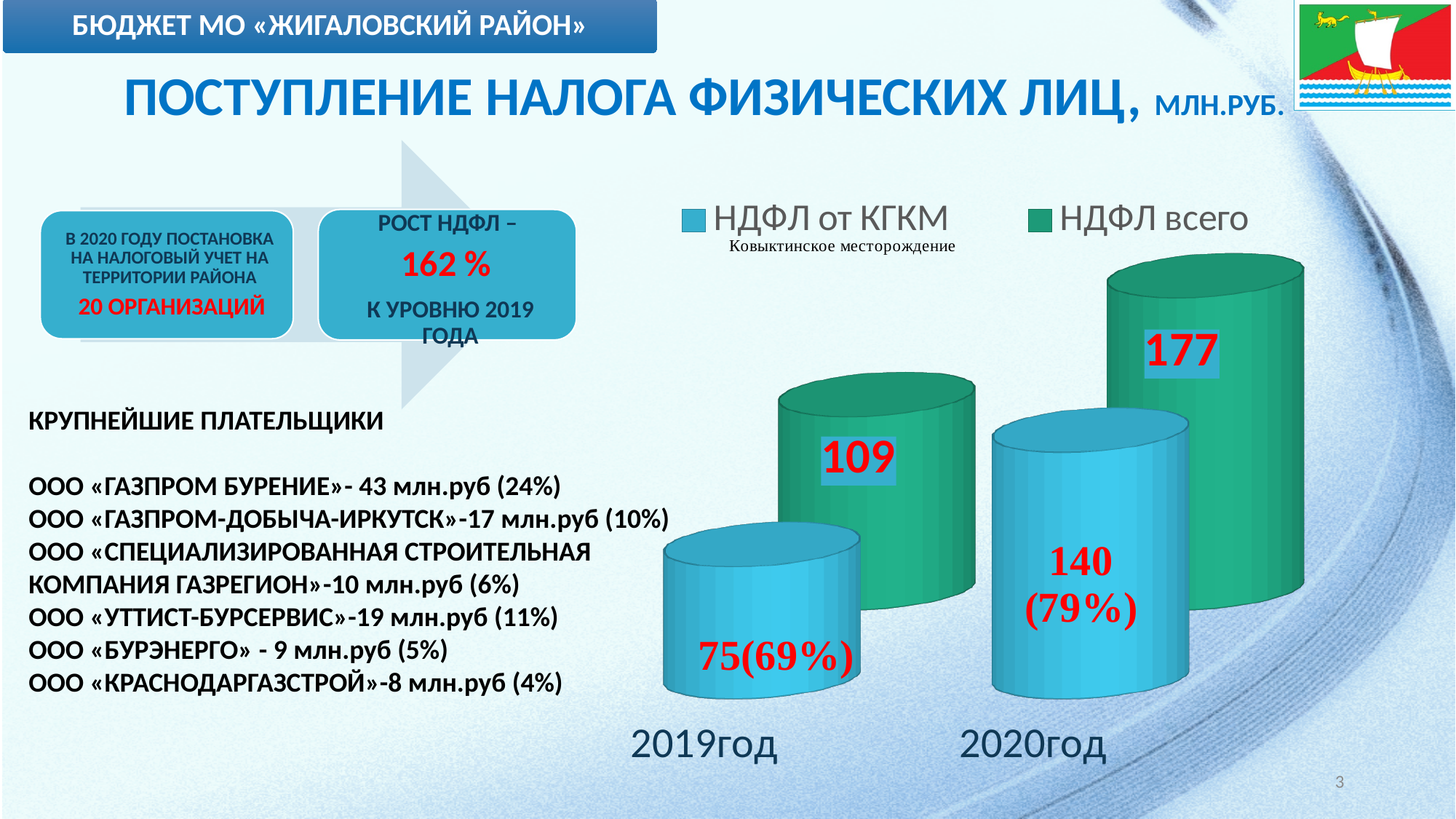
Does НДФЛ всего rise or fall from 2019год to 2020год? rise What is the value of НДФЛ всего for 2019год? 109 What value is labelled on the НДФЛ от КГКМ bar for 2019год? 75(69%) What value is labelled on the НДФЛ от КГКМ bar for 2020год? 140 (79%) How many series does the chart legend list? 2 Which is larger: НДФЛ от КГКМ in 2020год or НДФЛ всего in 2019год? НДФЛ от КГКМ in 2020год What is the value of НДФЛ всего for 2020год? 177 Which colour represents the НДФЛ всего series in the chart? green Which year has the higher value for НДФЛ всего? 2020год How many categories (years) are shown on the x axis of the chart? 2 Which year has the lower value for НДФЛ от КГКМ? 2019год What is the difference between НДФЛ всего in 2020год and 2019год? 68